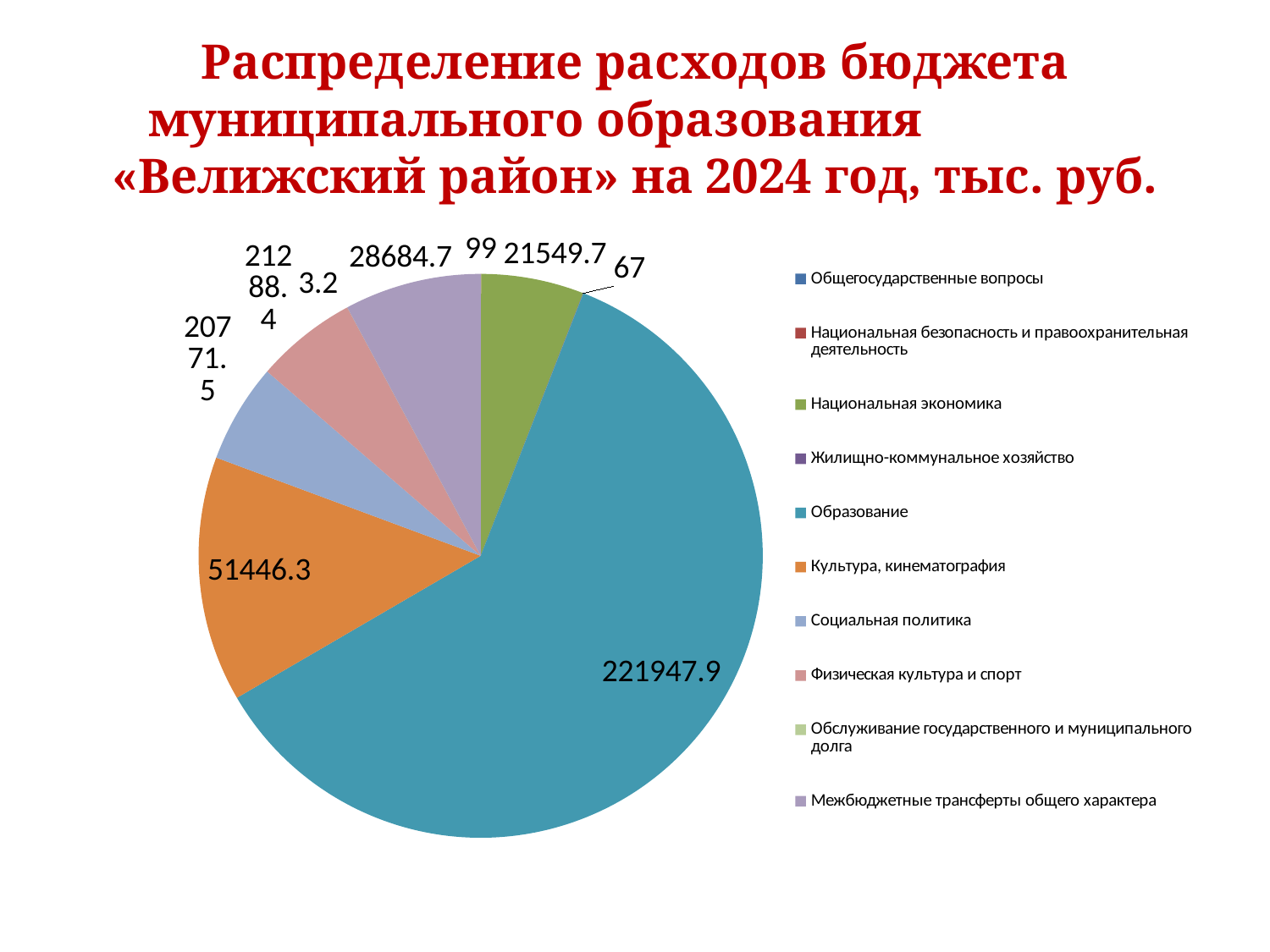
What is the value for Социальная политика? 20771.5 What is the value for Образование? 221947.9 What colour is the slice for Образование? teal What is the value for Культура, кинематография? 51446.3 What is the value for Физическая культура и спорт? 21288.4 What is the value for Национальная экономика? 21549.7 What is the difference between the values for Образование and Культура, кинематография? 170501.6 Which is larger: Культура, кинематография or Межбюджетные трансферты общего характера? Культура, кинематография Which category has the largest slice of the pie? Образование What is the value for Межбюджетные трансферты общего характера? 28684.7 How many categories does the legend list? 10 What type of chart is shown on the slide? pie chart